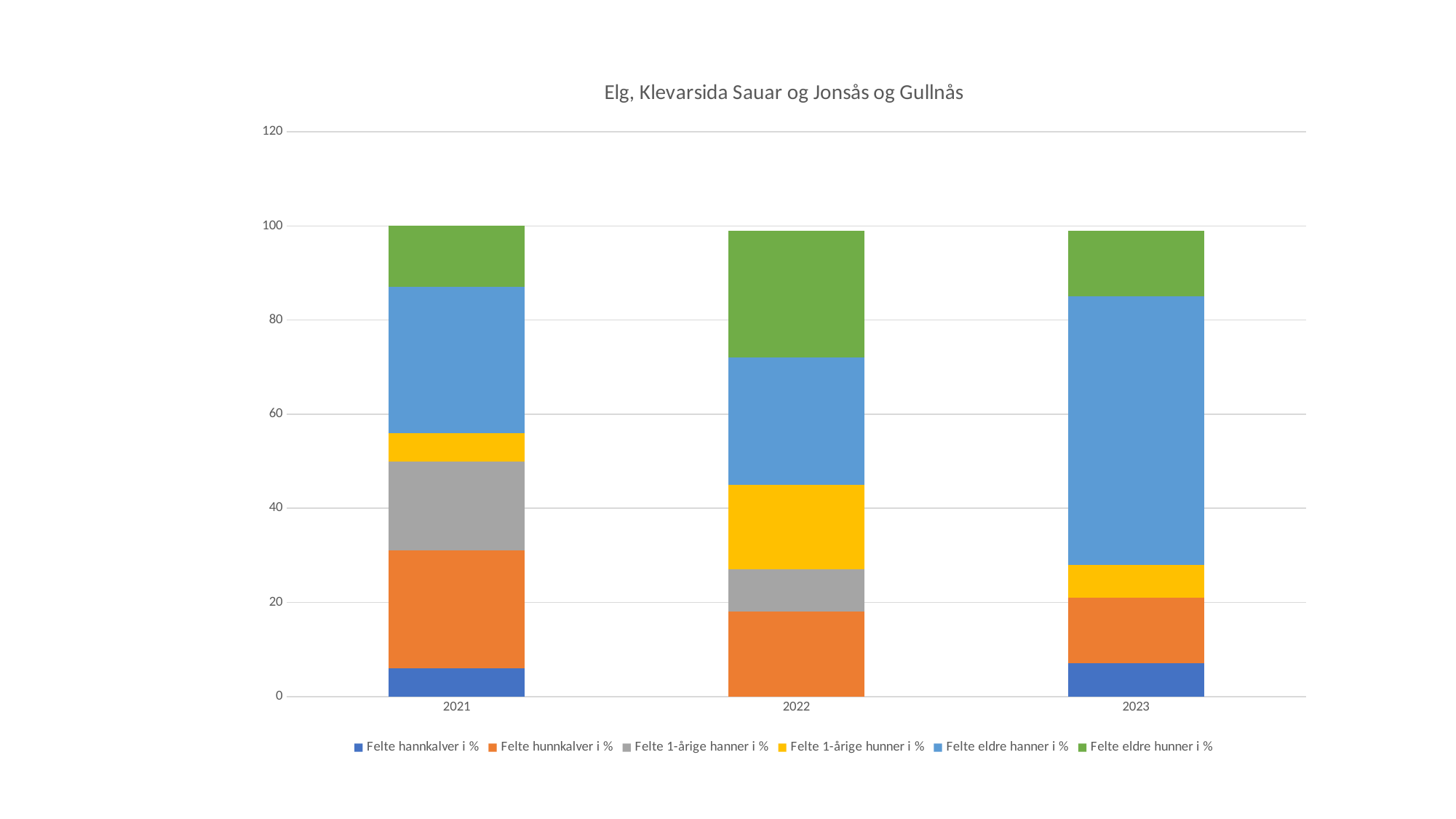
Is the value for Felte 1-årige hunner i % in 2022 greater or less than 10? greater Which year has the largest Felte eldre hanner i % segment? 2023 Is the value for Felte eldre hanner i % in 2023 greater or less than 40? greater Which year has the largest Felte eldre hunner i % segment? 2022 How many series does the legend list? 6 How many years are shown on the x axis of the chart? 3 Which year has the larger Felte 1-årige hanner i % segment, 2021 or 2022? 2021 Which colour represents Felte eldre hunner i % in the chart? Green Is the value for Felte hannkalver i % in 2021 greater or less than 20? less What is the title of the chart? Elg, Klevarsida Sauar og Jonsås og Gullnås What kind of chart is shown on the slide? Stacked bar chart Does the Felte hunnkalver i % segment rise or fall from 2021 to 2023? Fall